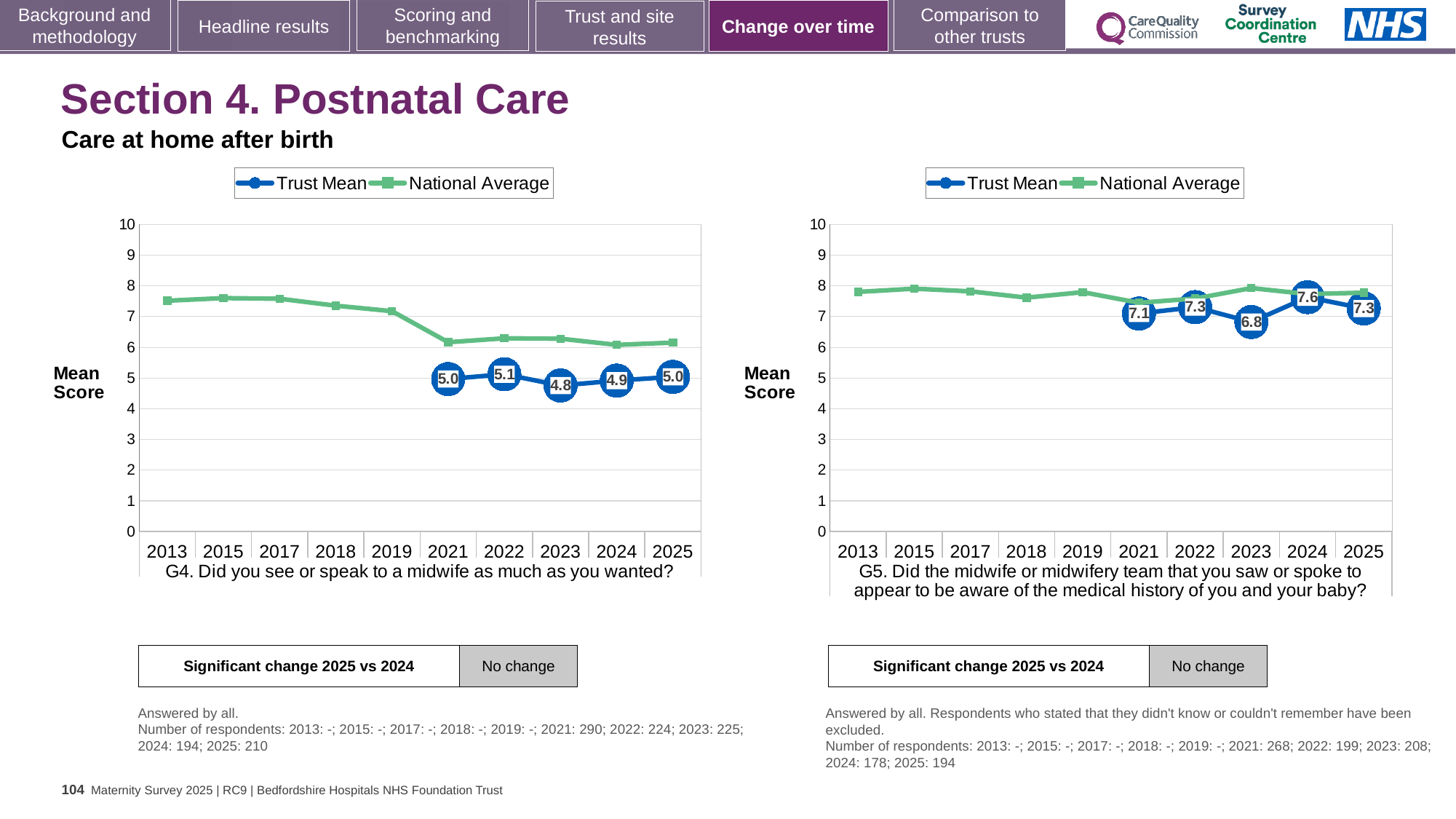
In the G5 chart (right), what is the difference between the Trust Mean for 2024 and the Trust Mean for 2023? 0.8 In the G5 chart (right), which year has the lowest Trust Mean? 2023 In the G4 chart (left), does the National Average rise or fall from 2019 to 2021? Fall In the G4 chart (left), which year has the highest Trust Mean? 2022 In the G4 chart (left), is the National Average for 2013 greater or less than 7? greater In the G4 chart (left), which is larger: the Trust Mean for 2021 or the Trust Mean for 2023? 2021 How many years are shown on the x axis of the G4 chart (left)? 10 In the G5 chart (right), what is the Trust Mean for 2024? 7.6 In the G5 chart (right), is the National Average for 2025 greater or less than 7? greater In the G4 chart (left), what is the Trust Mean for 2023? 4.8 What kind of chart is the G4 chart (left)? Line chart How many series does the legend of the G5 chart (right) list? 2